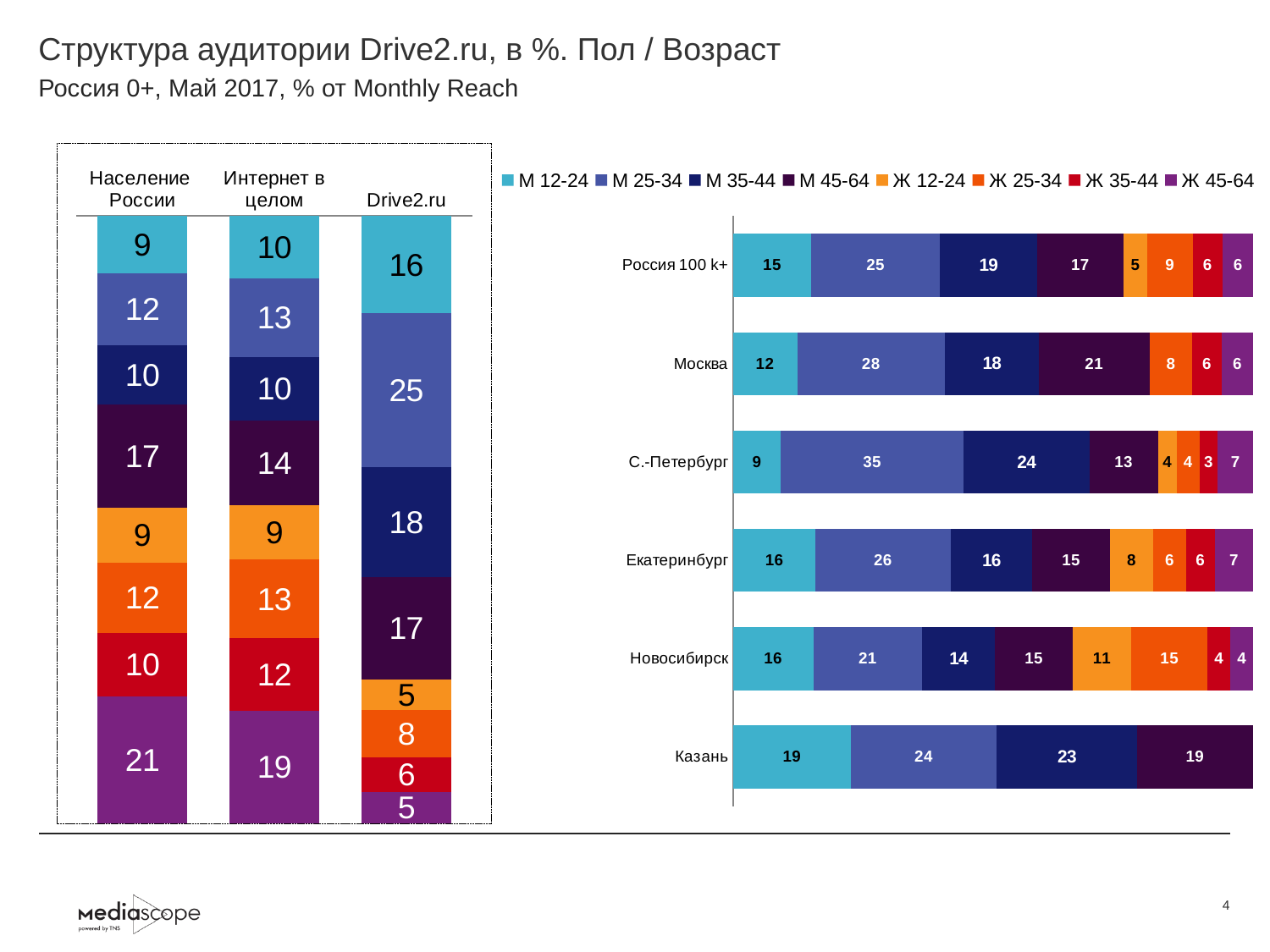
In the right chart, which is larger: the М 45-64 value for Москва or for Екатеринбург? Москва In the right chart, what is the value for Ж 25-34 for Новосибирск? 15 In the right chart, what is the total of the labelled segments for Казань? 85 How many series does the legend of the right chart list? 8 What type of chart is the right chart? Stacked bar chart In the left chart, what is the difference between the М 25-34 values for Drive2.ru and Интернет в целом? 12 How many cities or regions are shown in the right chart? 6 In the left chart, what is the value for Ж 45-64 in the Население России column? 21 In the left chart, what is the value for М 25-34 in the Drive2.ru column? 25 In the right chart, what is the value for М 25-34 for С.-Петербург? 35 In the left chart, which column has the lowest value for Ж 35-44? Drive2.ru In the right chart, which city has the highest value for М 25-34? С.-Петербург